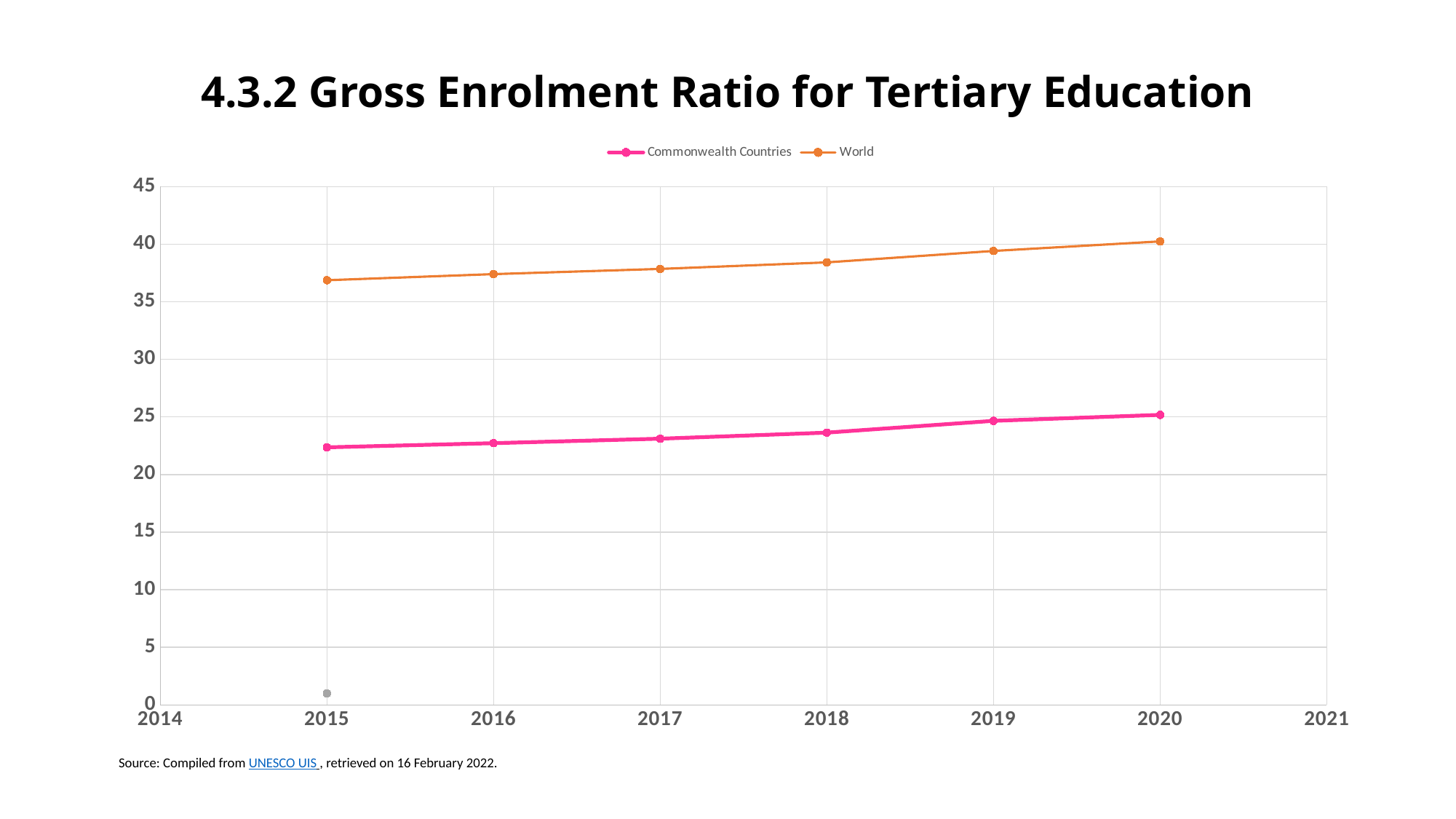
Do the values for the World series rise or fall from 2015 to 2020? rise What is the title of the chart? 4.3.2 Gross Enrolment Ratio for Tertiary Education In which year is the Commonwealth Countries value highest? 2020 What kind of chart is shown on the slide? line chart How many years have plotted data points for the Commonwealth Countries series? 6 How many series does the legend list? 2 Is the value for World in 2015 greater or less than 35? greater In which year is the World value lowest? 2015 Which series has the higher value in 2018, Commonwealth Countries or World? World Is the value for Commonwealth Countries in 2015 greater or less than 25? less Which colour is used for the World series? orange Do the values for Commonwealth Countries rise or fall from 2015 to 2020? rise